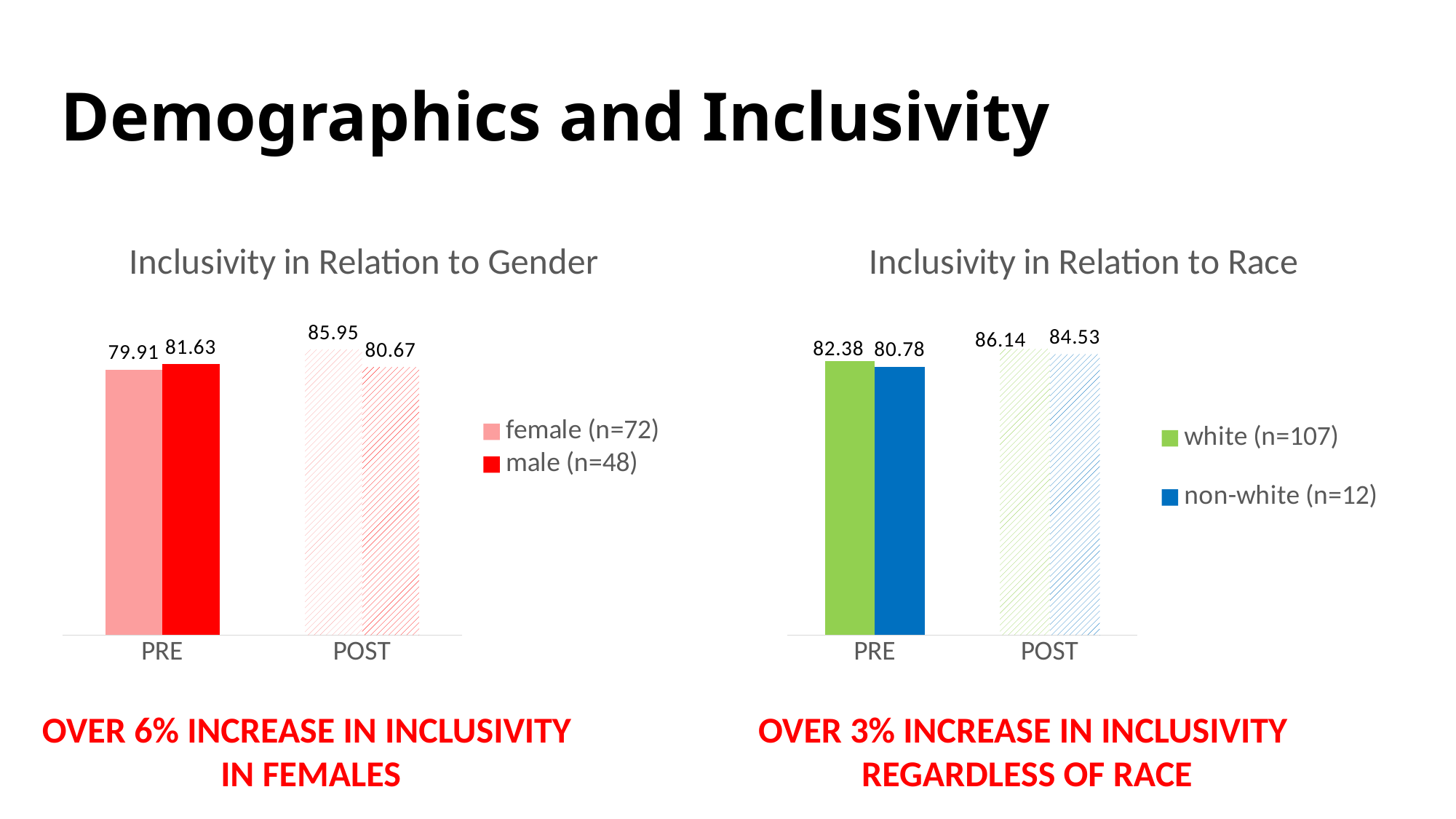
In the 'Inclusivity in Relation to Gender' chart, what is the value for male (n=48) at POST? 80.67 In the 'Inclusivity in Relation to Race' chart, what is the difference between the white (n=107) and non-white (n=12) values at POST? 1.61 In the 'Inclusivity in Relation to Race' chart, what is the value for white (n=107) at POST? 86.14 How many series does the legend of the 'Inclusivity in Relation to Race' chart list? 2 In the 'Inclusivity in Relation to Race' chart, does the non-white (n=12) value rise or fall from PRE to POST? Rise What kind of chart is 'Inclusivity in Relation to Gender'? Bar chart In the 'Inclusivity in Relation to Gender' chart, what is the value for female (n=72) at PRE? 79.91 In the 'Inclusivity in Relation to Gender' chart, which is larger at PRE: female (n=72) or male (n=48)? male (n=48) In the 'Inclusivity in Relation to Race' chart, which series and category has the lowest value? non-white (n=12) at PRE In the 'Inclusivity in Relation to Gender' chart, which series and category has the highest value? female (n=72) at POST In the 'Inclusivity in Relation to Gender' chart, what is the difference between the female (n=72) POST and PRE values? 6.04 In the 'Inclusivity in Relation to Race' chart, what is the value for non-white (n=12) at PRE? 80.78